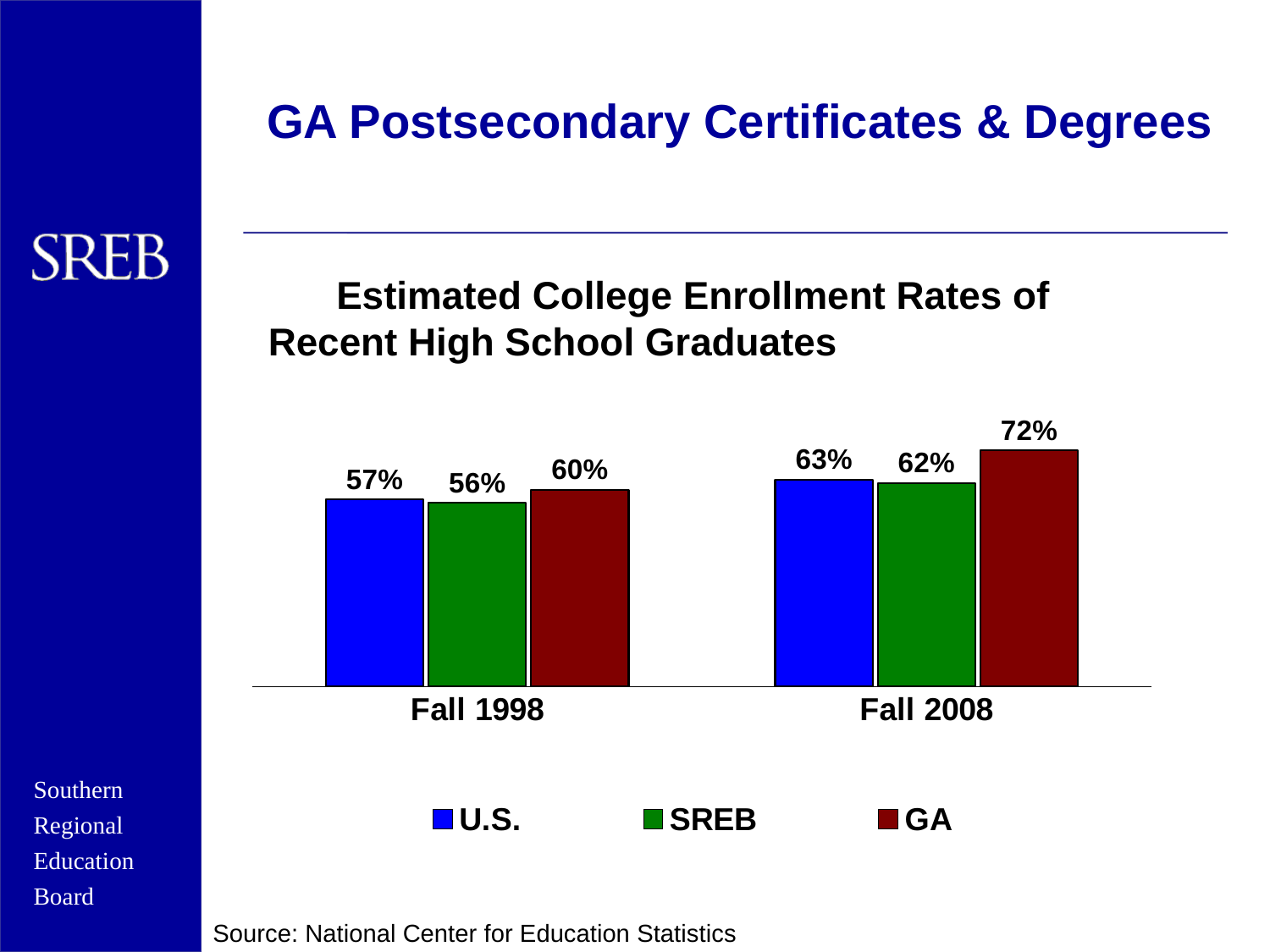
What is the difference between the GA and U.S. values in Fall 2008? 9% What is the value for GA in Fall 2008? 72% Which series has the highest value in Fall 2008? GA What is the value for U.S. in Fall 1998? 57% Which is larger in Fall 1998, the U.S. value or the GA value? GA How many series does the legend list? 3 How many categories are shown on the x axis? 2 Do the U.S. values rise or fall from Fall 1998 to Fall 2008? Rise Which series has the lowest value in Fall 1998? SREB What is the difference between the GA value in Fall 2008 and the GA value in Fall 1998? 12% What is the value for SREB in Fall 2008? 62% What kind of chart is shown? Bar chart